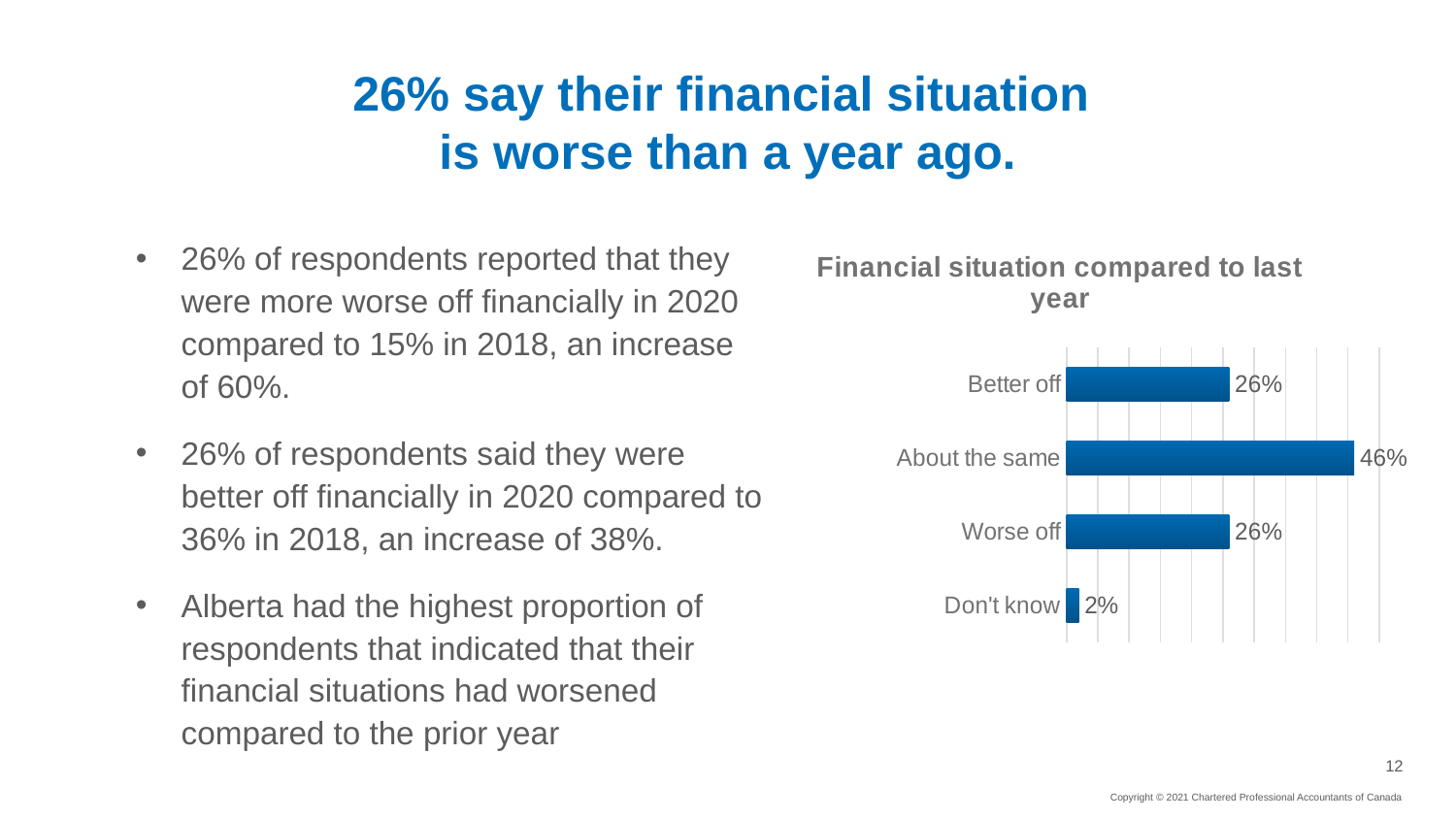
Which category has the lowest value? Don't know What kind of chart is shown on the slide? Bar chart What is the difference between the 'Worse off' value and the 'Don't know' value? 24% What value is shown for the 'Don't know' category? 2% Which category has the highest value? About the same What value is shown for the 'Better off' category? 26% What is the title of the chart? Financial situation compared to last year Which is larger, the value for 'About the same' or the value for 'Better off'? About the same What value is shown for the 'Worse off' category? 26% What is the difference between the 'About the same' value and the 'Worse off' value? 20% What percentage of respondents said their financial situation was about the same as last year? 46% How many categories are shown in the chart? 4